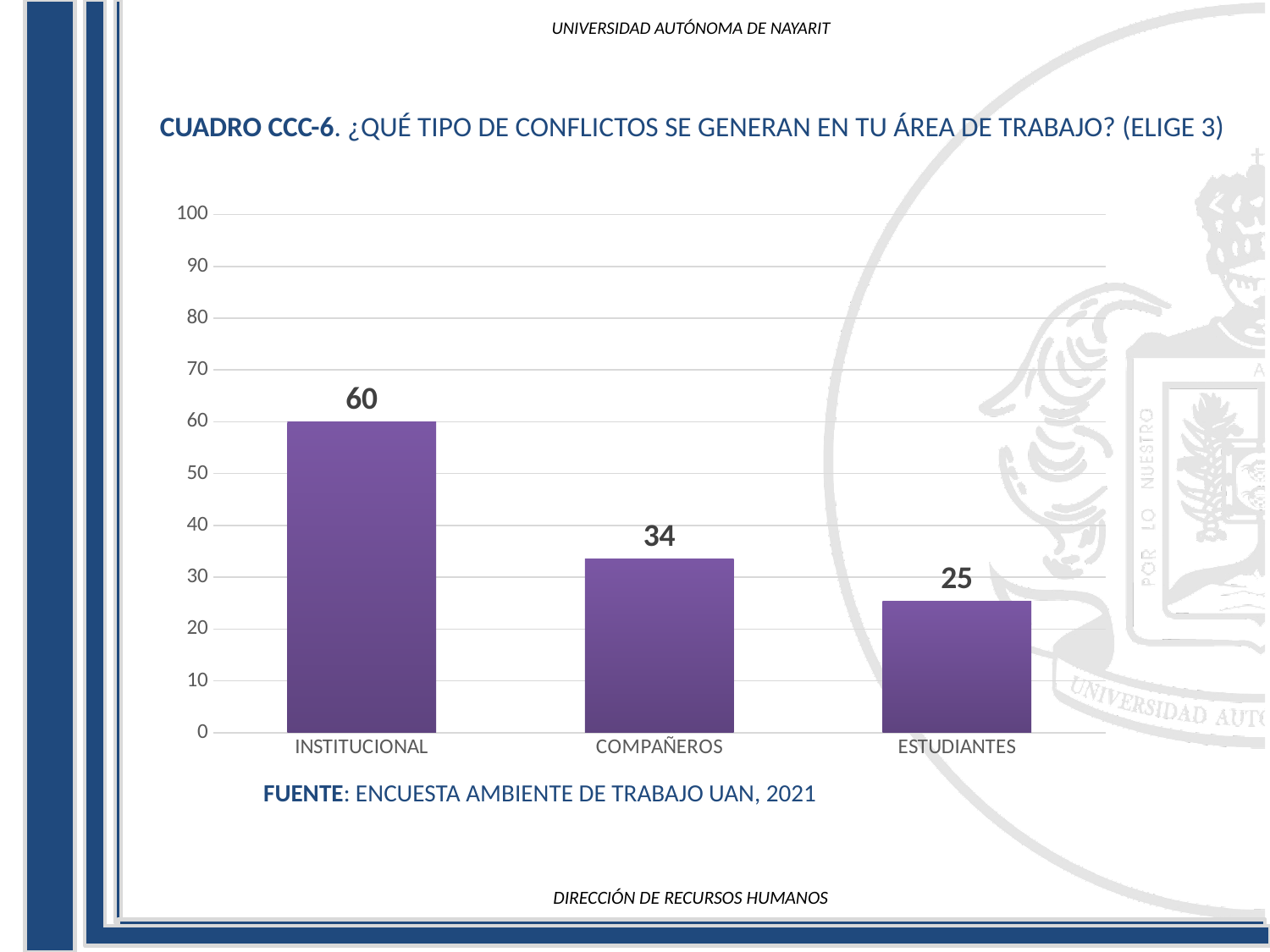
What is the source cited below the chart? ENCUESTA AMBIENTE DE TRABAJO UAN, 2021 What is the value for COMPAÑEROS? 34 Which category has the lowest value? ESTUDIANTES How many categories are shown in the chart? 3 What is the difference between the values for COMPAÑEROS and ESTUDIANTES? 9 What is the value for INSTITUCIONAL? 60 Which is larger, the value for COMPAÑEROS or the value for ESTUDIANTES? COMPAÑEROS What is the difference between the values for INSTITUCIONAL and COMPAÑEROS? 26 Which category has the highest value? INSTITUCIONAL What kind of chart is shown on the slide? bar chart What is the value for ESTUDIANTES? 25 Is the value for INSTITUCIONAL greater or less than 50? greater